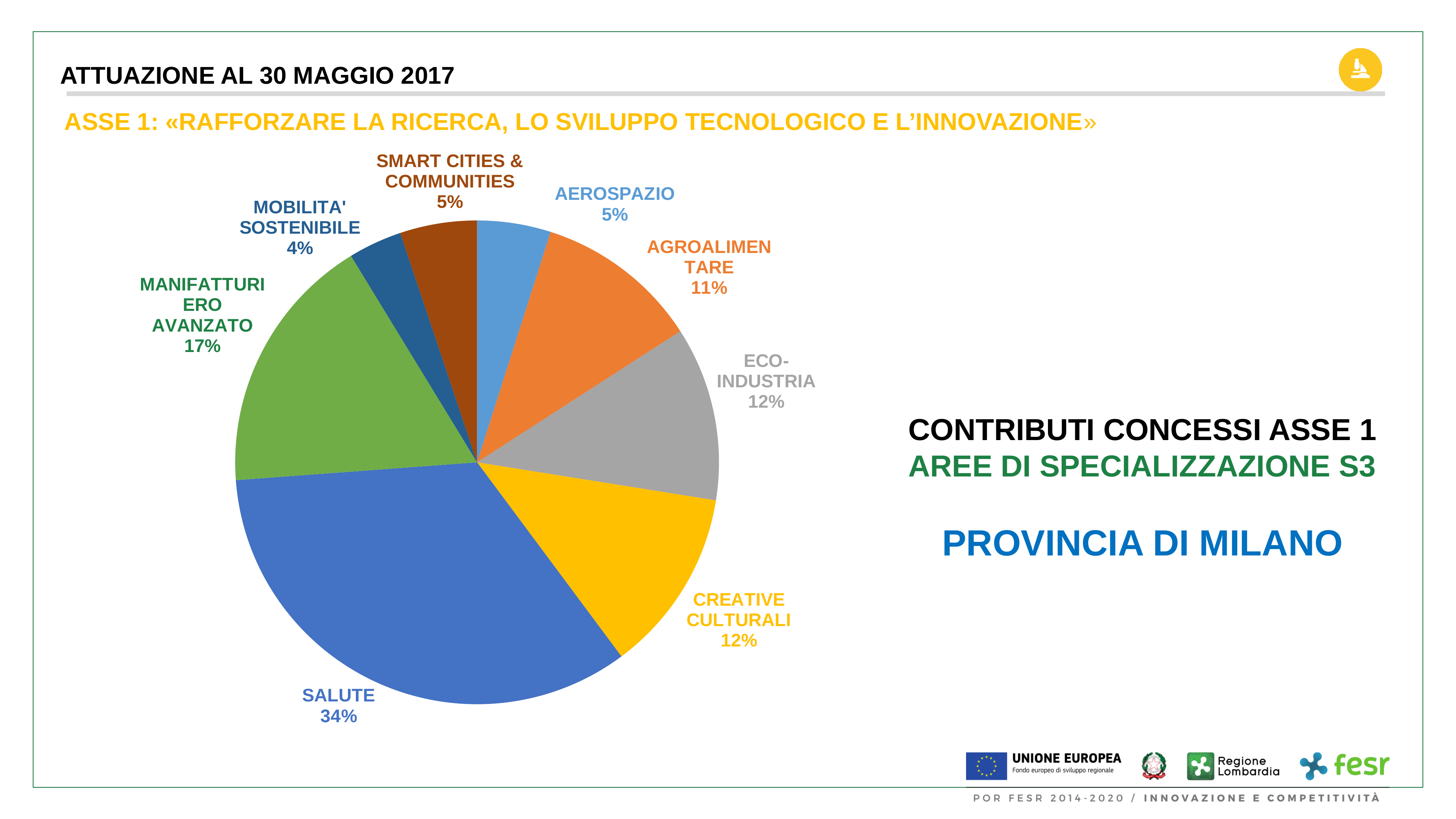
Which province does the chart refer to, according to the text on the slide? PROVINCIA DI MILANO What is the difference between the SALUTE share and the MANIFATTURIERO AVANZATO share? 17% What kind of chart is shown on the slide? pie chart What is the value shown for MOBILITA' SOSTENIBILE? 4% Which category has the largest slice of the pie? SALUTE Which is larger, the share for ECO-INDUSTRIA or the share for AGROALIMENTARE? ECO-INDUSTRIA How many categories are shown in the pie chart? 8 What share of the pie does SALUTE represent? 34% What is the value shown for SMART CITIES & COMMUNITIES? 5% What is the value shown for AGROALIMENTARE? 11% Which category has the smallest slice of the pie? MOBILITA' SOSTENIBILE What is the value shown for MANIFATTURIERO AVANZATO? 17%